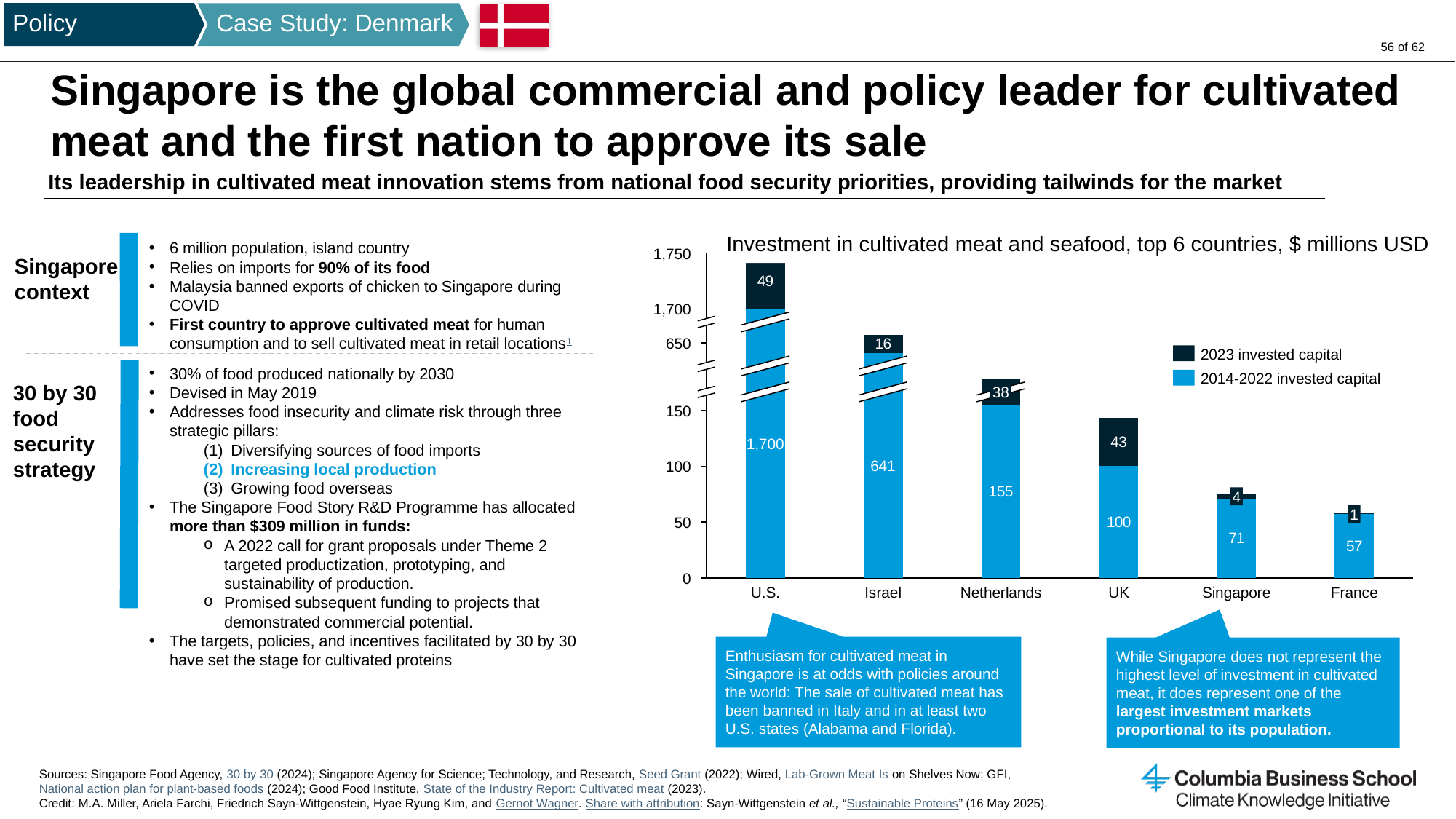
Which country has the highest 2014-2022 invested capital? U.S. Which country has the lowest 2023 invested capital? France Which is larger: the 2023 invested capital for the Netherlands or for the UK? UK What is the title of the chart? Investment in cultivated meat and seafood, top 6 countries, $ millions USD What is the 2014-2022 invested capital for the U.S.? 1,700 How many countries are shown on the x axis? 6 How many series does the legend list? 2 What kind of chart is shown? Stacked bar chart What is the difference between the 2014-2022 invested capital of Israel and the Netherlands? 486 What is the 2023 invested capital for the UK? 43 What is the total invested capital (2014-2022 plus 2023) for Singapore? 75 What is the 2014-2022 invested capital for Singapore? 71